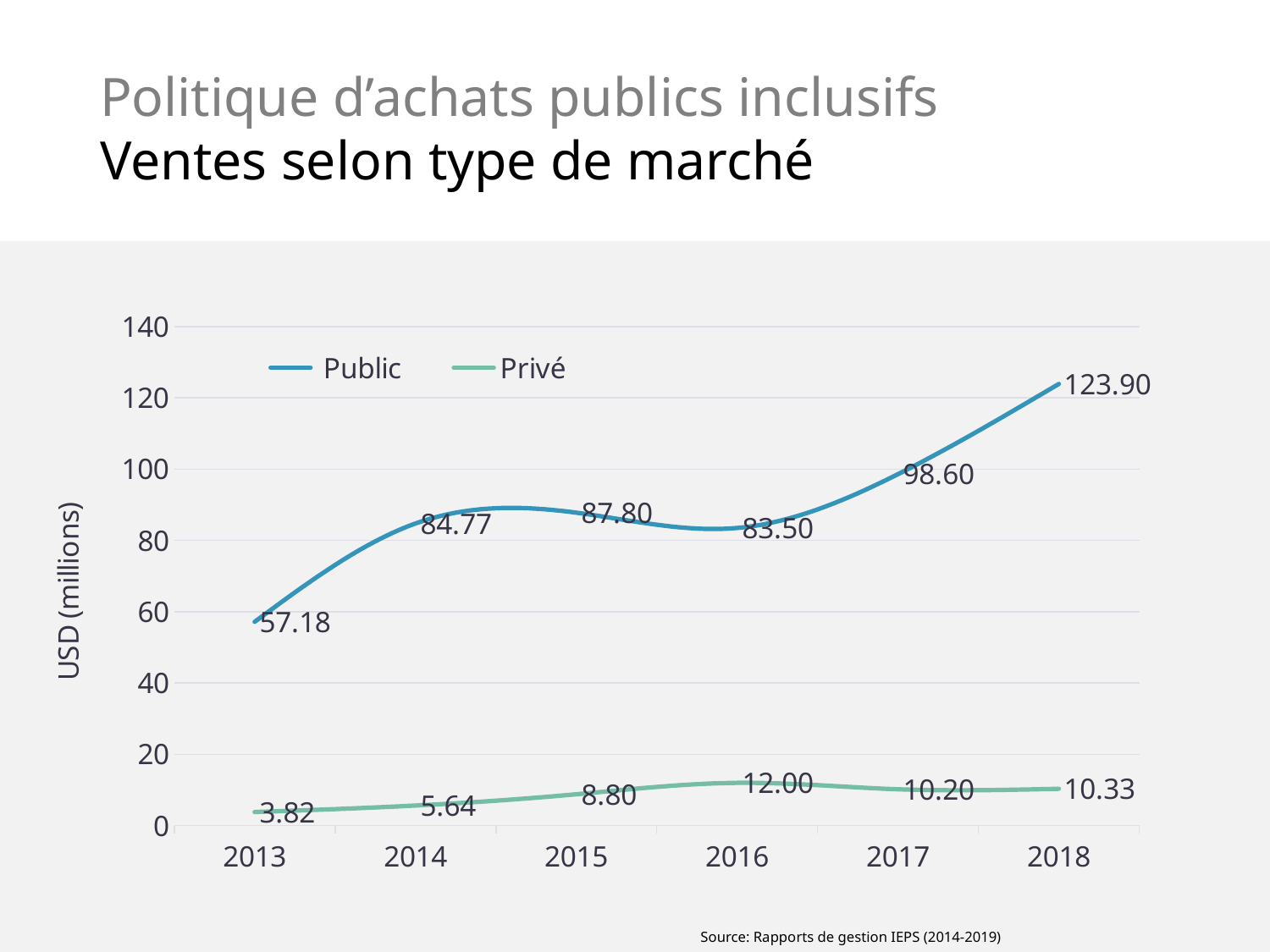
What kind of chart is shown? line chart What is the value for Public in 2013? 57.18 Which is larger, the Public value in 2015 or the Public value in 2016? 2015 In which year is the Privé series lowest? 2013 What is the value for Public in 2018? 123.90 What is the label of the y axis? USD (millions) What is the value for Privé in 2016? 12.00 In which year is the Public series highest? 2018 Is the value for Public in 2017 greater or less than 100? less How many series does the legend list? 2 How many years are shown on the x axis? 6 What is the difference between the Public values in 2018 and 2017? 25.30